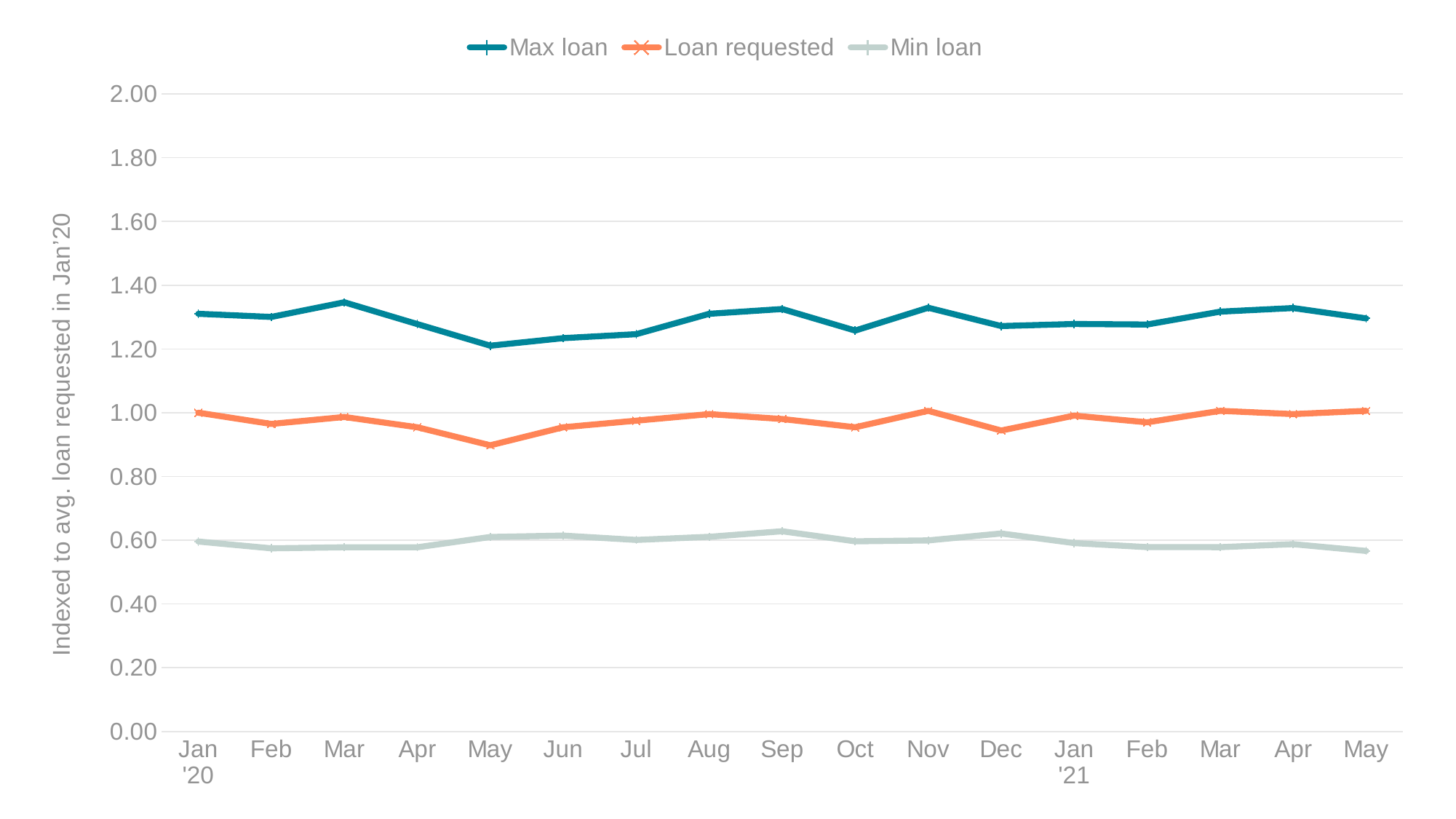
Is the value for Max loan in Mar '20 greater or less than 1.20? greater In which month is the Max loan series at its lowest? May '20 Which series has the larger value in Jan '21, Max loan or Min loan? Max loan In which month is the Loan requested series at its lowest? May '20 Which series is listed first in the legend? Max loan Is the value for Loan requested in May '20 greater or less than 1.00? less How many series does the legend list? 3 Is the value for Max loan in May '20 greater or less than 1.40? less What is the title of the vertical axis? Indexed to avg. loan requested in Jan'20 Does the Max loan series rise or fall from Mar '20 to May '20? fall How many months are plotted along the x axis? 17 What kind of chart is shown on the slide? Line chart